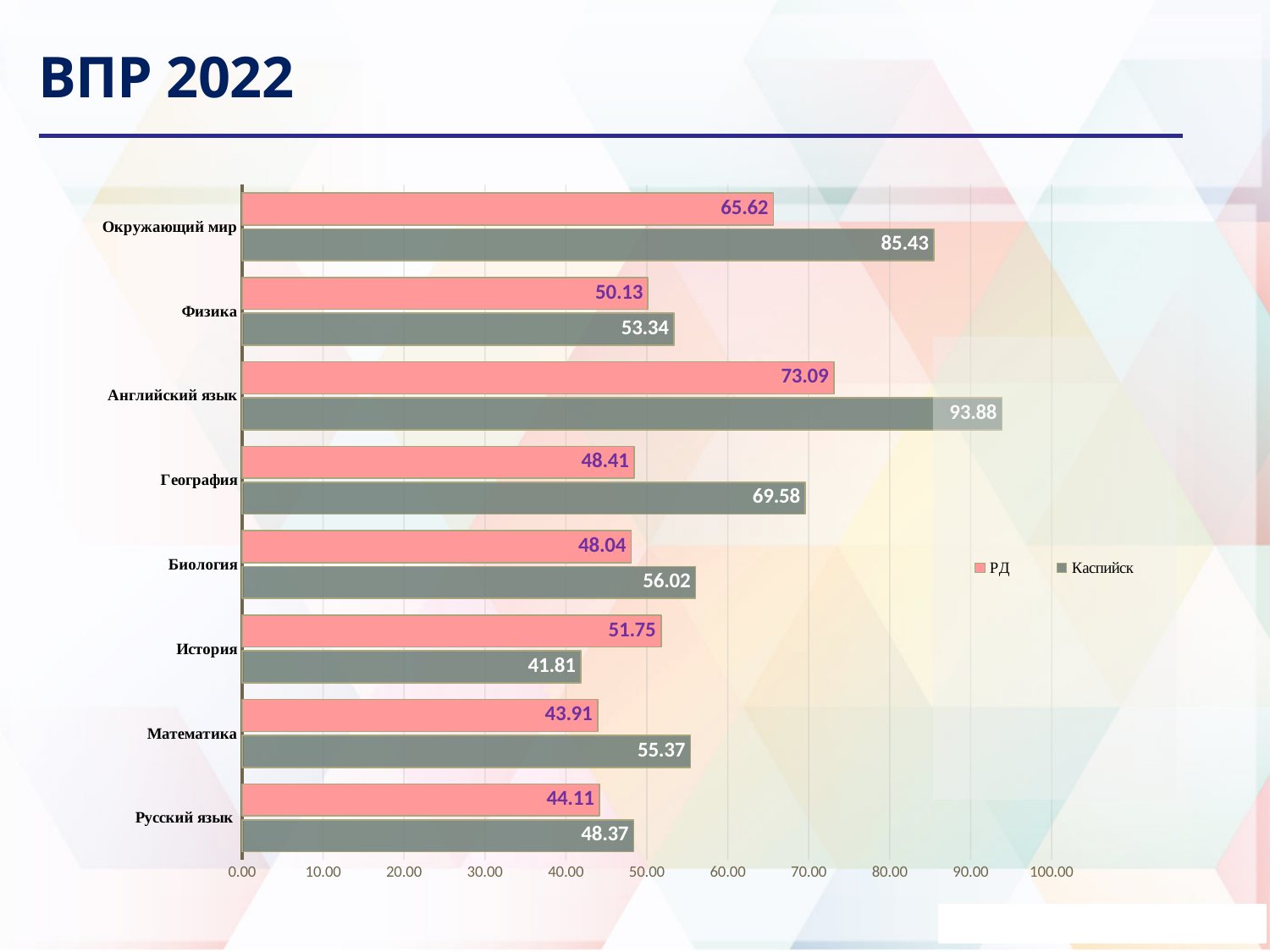
What is the difference between the Каспийск and РД values for География? 21.17 What is the value for Каспийск in История? 41.81 Which category has the highest value for the РД series? Английский язык How many series does the legend list? 2 Which is larger in История: the РД value or the Каспийск value? РД What is the value for РД in Окружающий мир? 65.62 What kind of chart is shown on the slide? bar chart What is the title of the slide? ВПР 2022 What is the value for Каспийск in Английский язык? 93.88 How many categories are shown on the chart? 8 Is the value for Каспийск in Окружающий мир greater or less than 80.00? greater Which category has the lowest value for the Каспийск series? История